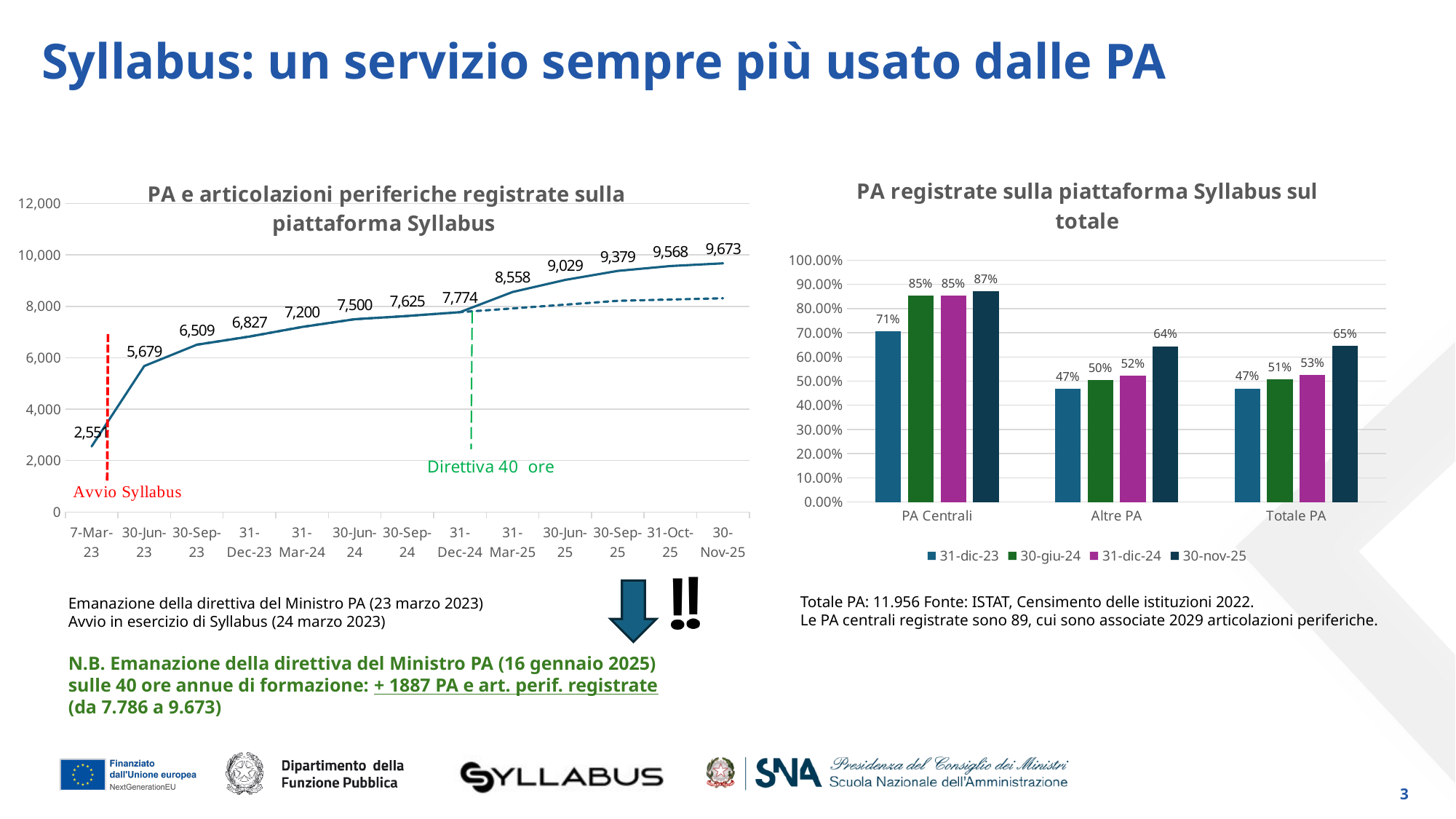
In the chart 'PA e articolazioni periferiche registrate sulla piattaforma Syllabus', what is the value at 7-Mar-23? 2,551 In the chart 'PA registrate sulla piattaforma Syllabus sul totale', how many series does the legend list? 4 In the chart 'PA registrate sulla piattaforma Syllabus sul totale', which category has the highest value for 30-nov-25? PA Centrali In the chart 'PA registrate sulla piattaforma Syllabus sul totale', what is the value for PA Centrali on 30-nov-25? 87% In the chart 'PA e articolazioni periferiche registrate sulla piattaforma Syllabus', what is the difference between the values at 31-Mar-25 and 31-Dec-24? 784 What kind of chart is 'PA e articolazioni periferiche registrate sulla piattaforma Syllabus'? line chart In the chart 'PA registrate sulla piattaforma Syllabus sul totale', what is the value for Altre PA on 31-dic-23? 47% In the chart 'PA e articolazioni periferiche registrate sulla piattaforma Syllabus', what is the value at 31-Dec-24? 7,774 In the chart 'PA registrate sulla piattaforma Syllabus sul totale', what is the difference between the Totale PA values for 30-nov-25 and 31-dic-23? 18% In the chart 'PA e articolazioni periferiche registrate sulla piattaforma Syllabus', do the values rise or fall over time? rise In the chart 'PA e articolazioni periferiche registrate sulla piattaforma Syllabus', what is the value at 30-Nov-25? 9,673 In the chart 'PA e articolazioni periferiche registrate sulla piattaforma Syllabus', how many data points are plotted on the solid line? 13